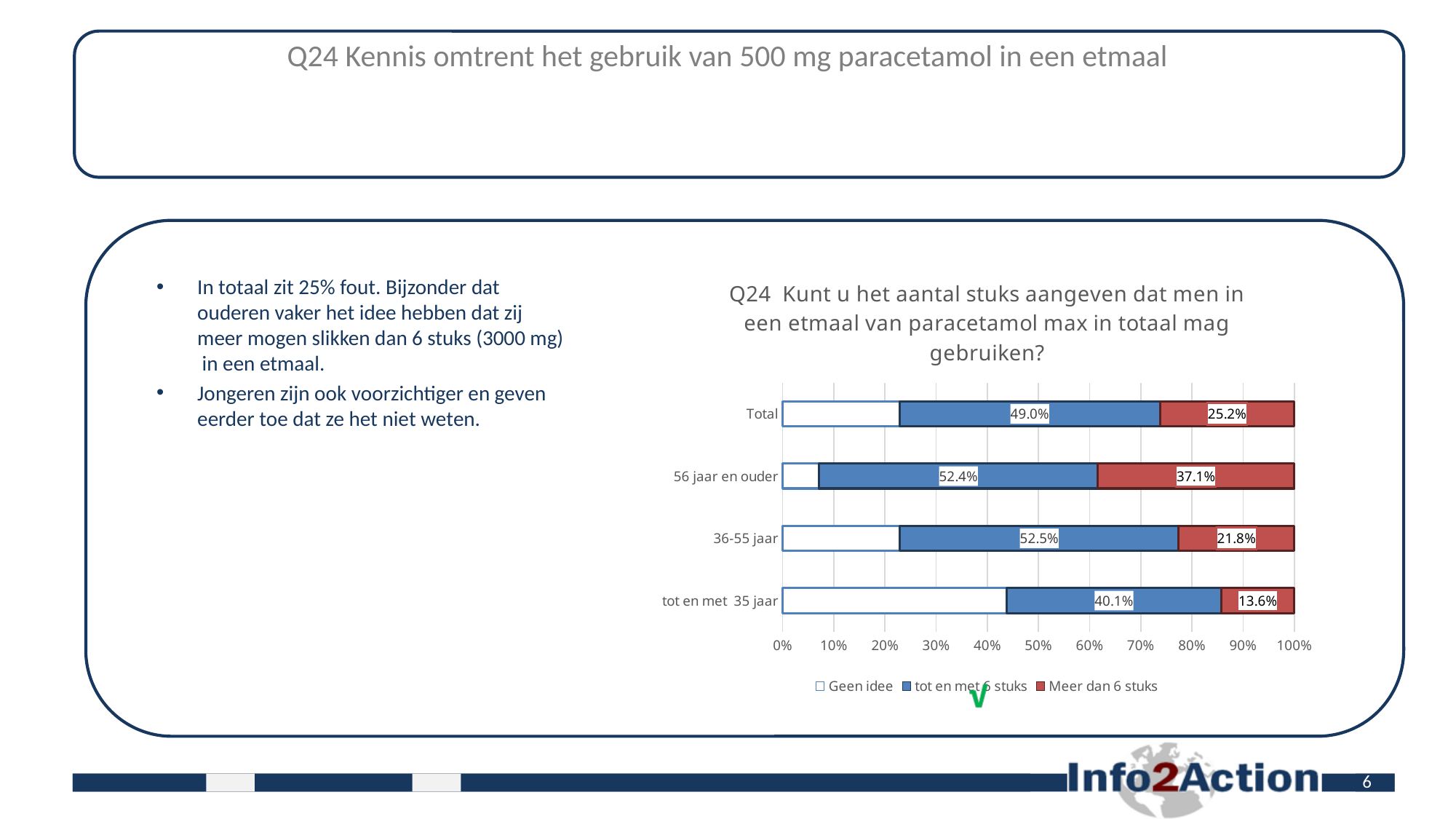
What kind of chart is shown on the slide? Stacked bar chart What is the value for 'tot en met 6 stuks' in the Total category? 49.0% Which age group has the highest value for 'Meer dan 6 stuks'? 56 jaar en ouder How many series does the legend list? 3 What is the value for 'tot en met 6 stuks' for the 'tot en met 35 jaar' group? 40.1% What is the value for 'Meer dan 6 stuks' for the '56 jaar en ouder' group? 37.1% What is the difference between the 'Meer dan 6 stuks' values for '56 jaar en ouder' and 'tot en met 35 jaar'? 23.5 percentage points Which category has the lowest value for 'Meer dan 6 stuks'? tot en met 35 jaar Which category has the lowest value for 'tot en met 6 stuks'? tot en met 35 jaar How many categories are shown on the y axis of the chart? 4 Is the 'Geen idee' value for '56 jaar en ouder' greater or less than 10%? less Which is larger: the 'Meer dan 6 stuks' value for Total or for '36-55 jaar'? Total